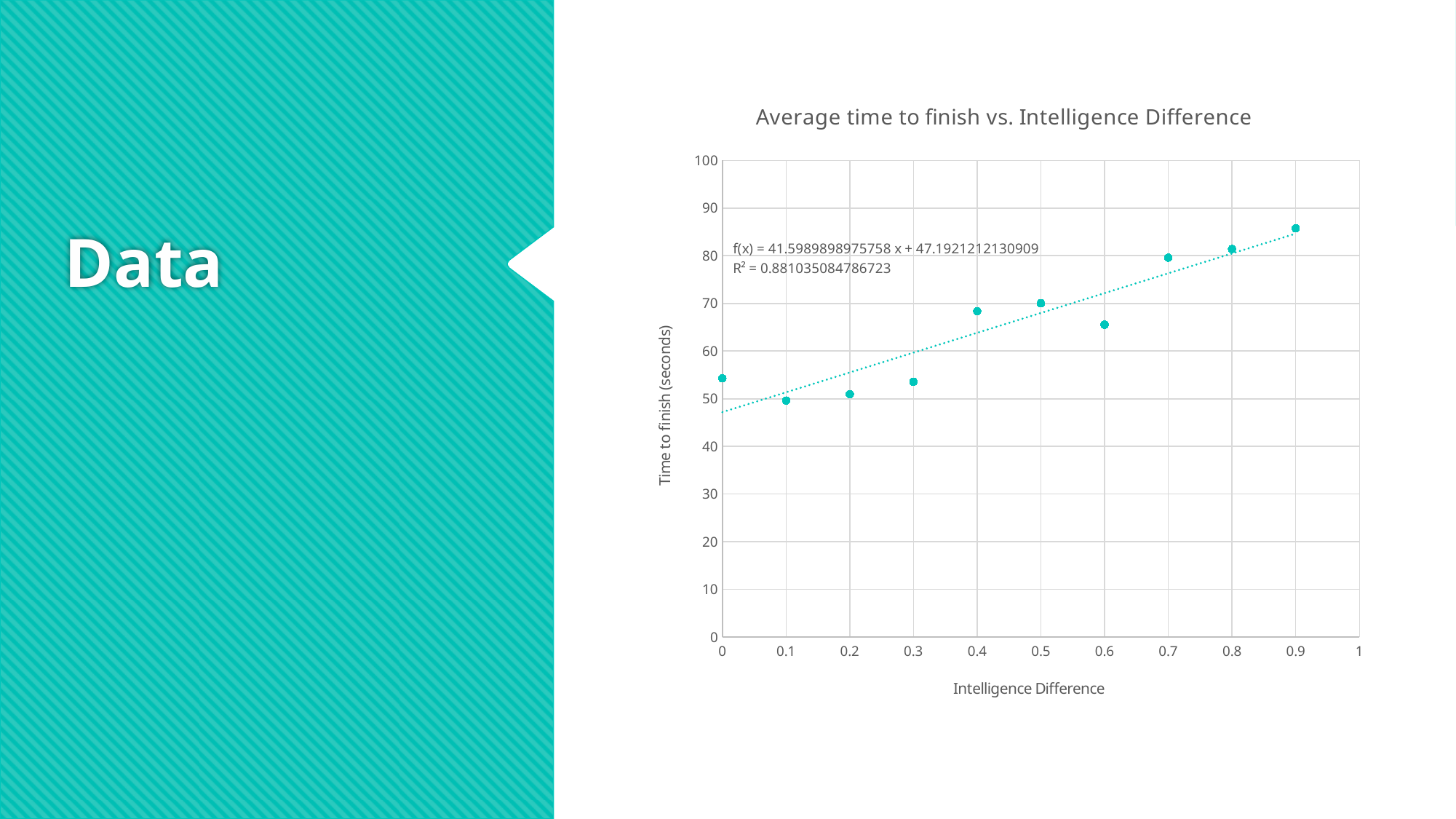
What kind of chart is shown on the slide? scatter plot At which Intelligence Difference value is the time to finish highest? 0.9 How many data points are plotted in the chart? 10 Is the time to finish at Intelligence Difference 0.4 greater or less than 60 seconds? greater Is the time to finish at Intelligence Difference 0.7 greater or less than 70 seconds? greater Overall, does the time to finish rise or fall as Intelligence Difference increases? rise What is the label of the y axis? Time to finish (seconds) What is the title of the chart? Average time to finish vs. Intelligence Difference Which has a larger time to finish: Intelligence Difference 0.8 or 0.3? 0.8 Is the time to finish at Intelligence Difference 0.1 greater or less than 60 seconds? less What R² value is printed on the chart for the trendline? 0.881035084786723